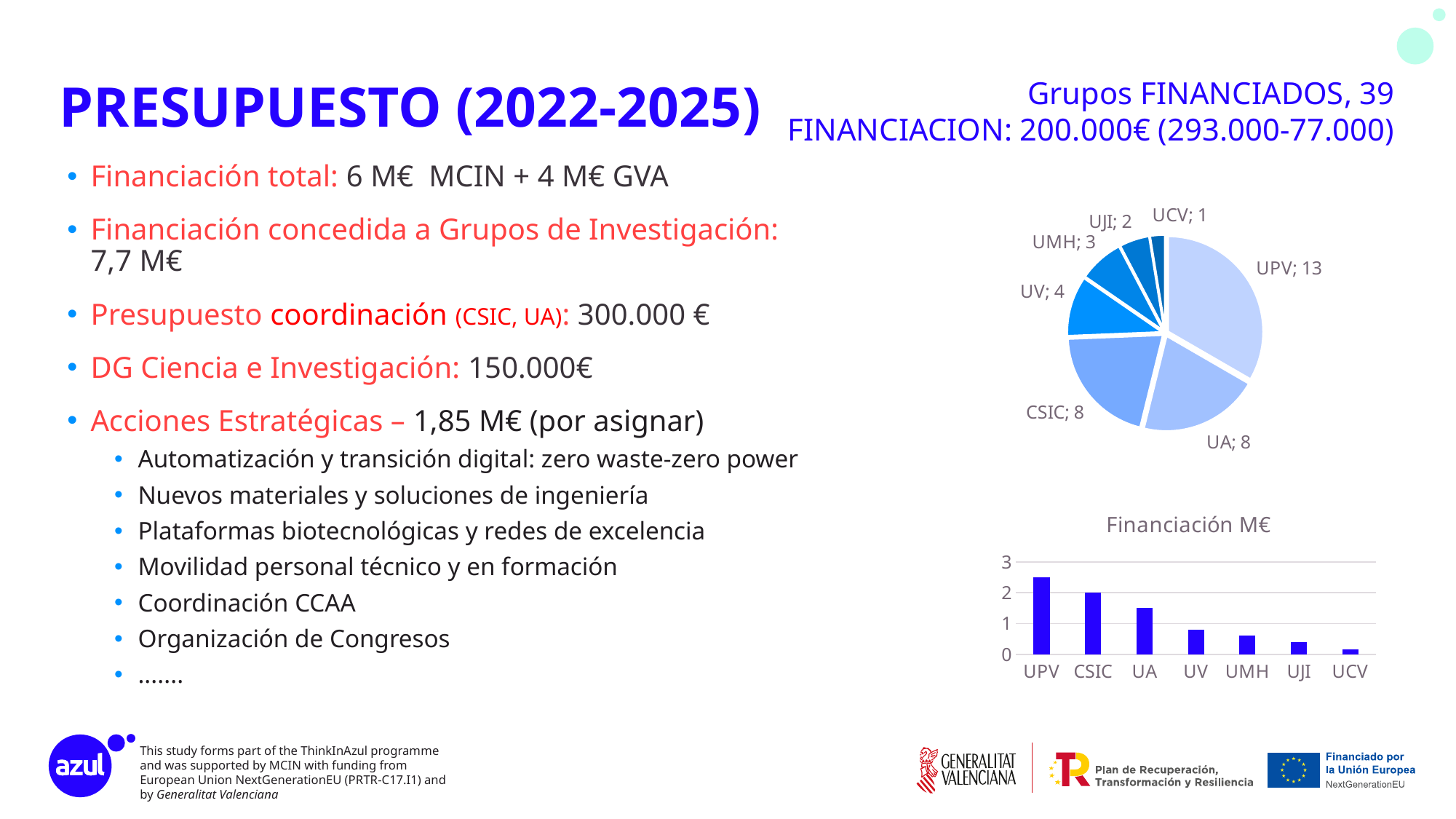
In the pie chart 'Grupos FINANCIADOS, 39', which institution has the smallest slice? UCV In the pie chart 'Grupos FINANCIADOS, 39', which is larger, the value for UV or the value for UJI? UV In the bar chart 'Financiación M€', is the value for UV greater or less than 1? less How many slices does the pie chart 'Grupos FINANCIADOS, 39' have? 7 In the pie chart 'Grupos FINANCIADOS, 39', how many groups does UPV have? 13 What kind of chart is the chart titled 'Financiación M€'? bar chart In the bar chart 'Financiación M€', is the value for UPV greater or less than 2? greater In the pie chart 'Grupos FINANCIADOS, 39', what is the difference between the values for UPV and CSIC? 5 In the pie chart 'Grupos FINANCIADOS, 39', which institution has the largest slice? UPV In the bar chart 'Financiación M€', do the values rise or fall from left to right along the x axis? fall In the pie chart 'Grupos FINANCIADOS, 39', what is the value for UMH? 3 In the bar chart 'Financiación M€', which institution has the highest bar? UPV